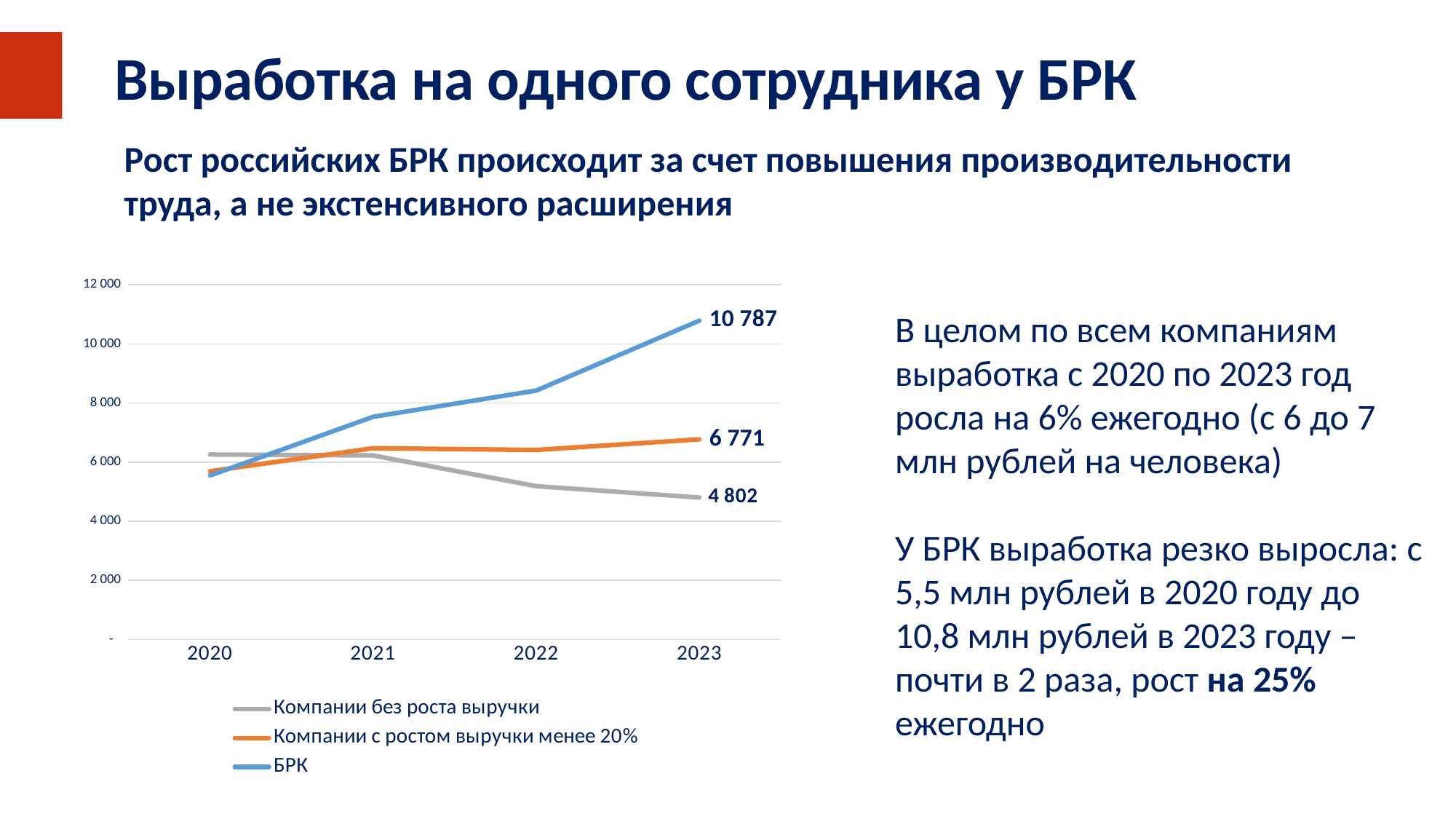
What is the difference between the 2023 values for БРК and Компании с ростом выручки менее 20%? 4 016 What is the value for БРК in 2023? 10 787 How many series does the legend list? 3 What is the value for Компании с ростом выручки менее 20% in 2023? 6 771 Is the value for БРК in 2022 greater or less than 8 000? greater Which series has the highest value in 2023? БРК Is the value for Компании без роста выручки in 2022 greater or less than 6 000? less Does the value for БРК rise or fall from 2020 to 2023? rises What is the value for Компании без роста выручки in 2023? 4 802 What is the difference between the 2023 values for Компании с ростом выручки менее 20% and Компании без роста выручки? 1 969 Which series has the lowest value in 2023? Компании без роста выручки How many years are shown on the x axis? 4